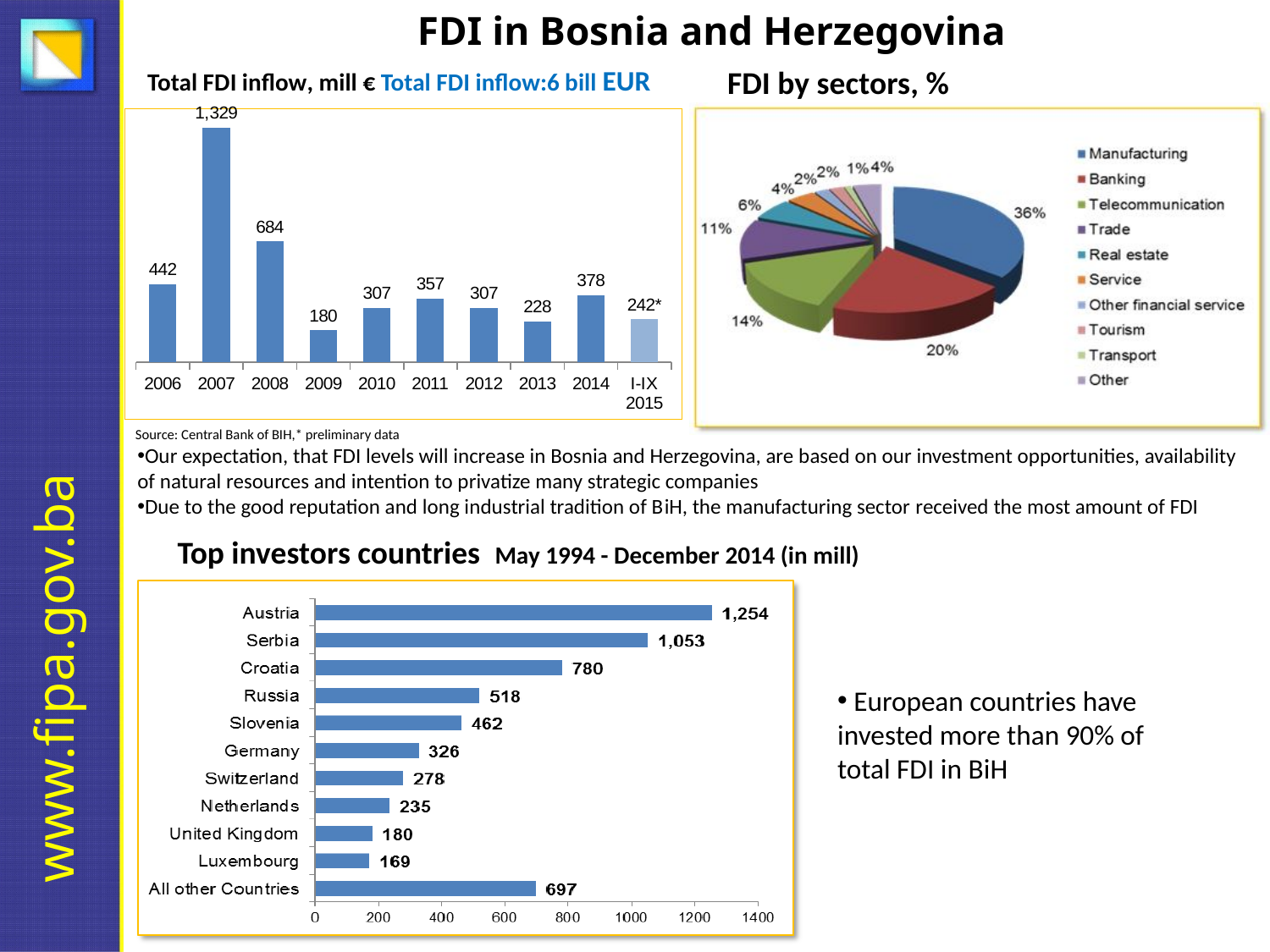
In the 'FDI by sectors, %' chart, what share does Manufacturing have? 36% In the 'Total FDI inflow, mill €' chart, how many bars are plotted? 10 In the 'FDI by sectors, %' chart, which sector has the second-largest share? Banking In the 'Top investors countries' chart, what is the value for Croatia? 780 What kind of chart is the 'Top investors countries' chart? bar chart In the 'Top investors countries' chart, what is the difference between the values for Austria and Serbia? 201 In the 'Total FDI inflow, mill €' chart, which year has the lowest FDI inflow? 2009 In the 'FDI by sectors, %' chart, how many sectors does the legend list? 10 In the 'Total FDI inflow, mill €' chart, what is the difference between the values for 2008 and 2009? 504 In the 'Top investors countries' chart, which country has the highest value? Austria In the 'Total FDI inflow, mill €' chart, what is the value for 2007? 1,329 In the 'Total FDI inflow, mill €' chart, is the value for 2014 larger or smaller than the value for 2013? larger